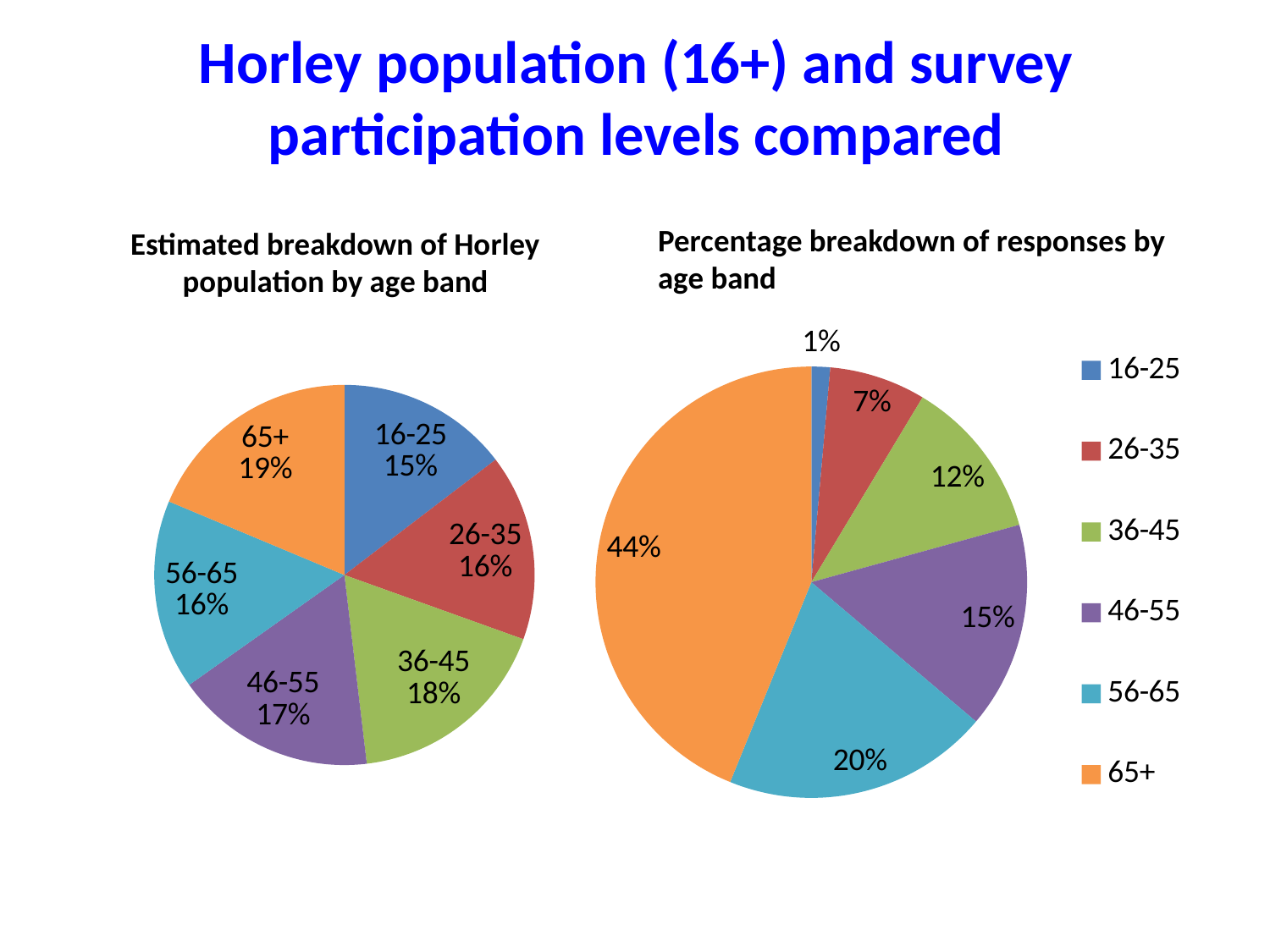
In the right pie chart (Percentage breakdown of responses by age band), which age band has the smallest share? 16-25 How many age bands are shown in the left pie chart (Estimated breakdown of Horley population by age band)? 6 In the right pie chart (Percentage breakdown of responses by age band), what share does the 65+ age band have? 44% In the left pie chart (Estimated breakdown of Horley population by age band), what share does the 65+ age band have? 19% In the left pie chart (Estimated breakdown of Horley population by age band), which age band has the smallest share? 16-25 In the left pie chart (Estimated breakdown of Horley population by age band), what share does the 36-45 age band have? 18% In the right pie chart (Percentage breakdown of responses by age band), which is larger: the share for 56-65 or the share for 46-55? 56-65 In the left pie chart (Estimated breakdown of Horley population by age band), which age band has the largest share? 65+ In the right pie chart (Percentage breakdown of responses by age band), what share does the 16-25 age band have? 1% What is the difference between the 65+ share in the right pie chart (44%) and the 65+ share in the left pie chart (19%)? 25 percentage points What type of chart is used for the Percentage breakdown of responses by age band? Pie chart In the right pie chart (Percentage breakdown of responses by age band), which age band has the largest share? 65+